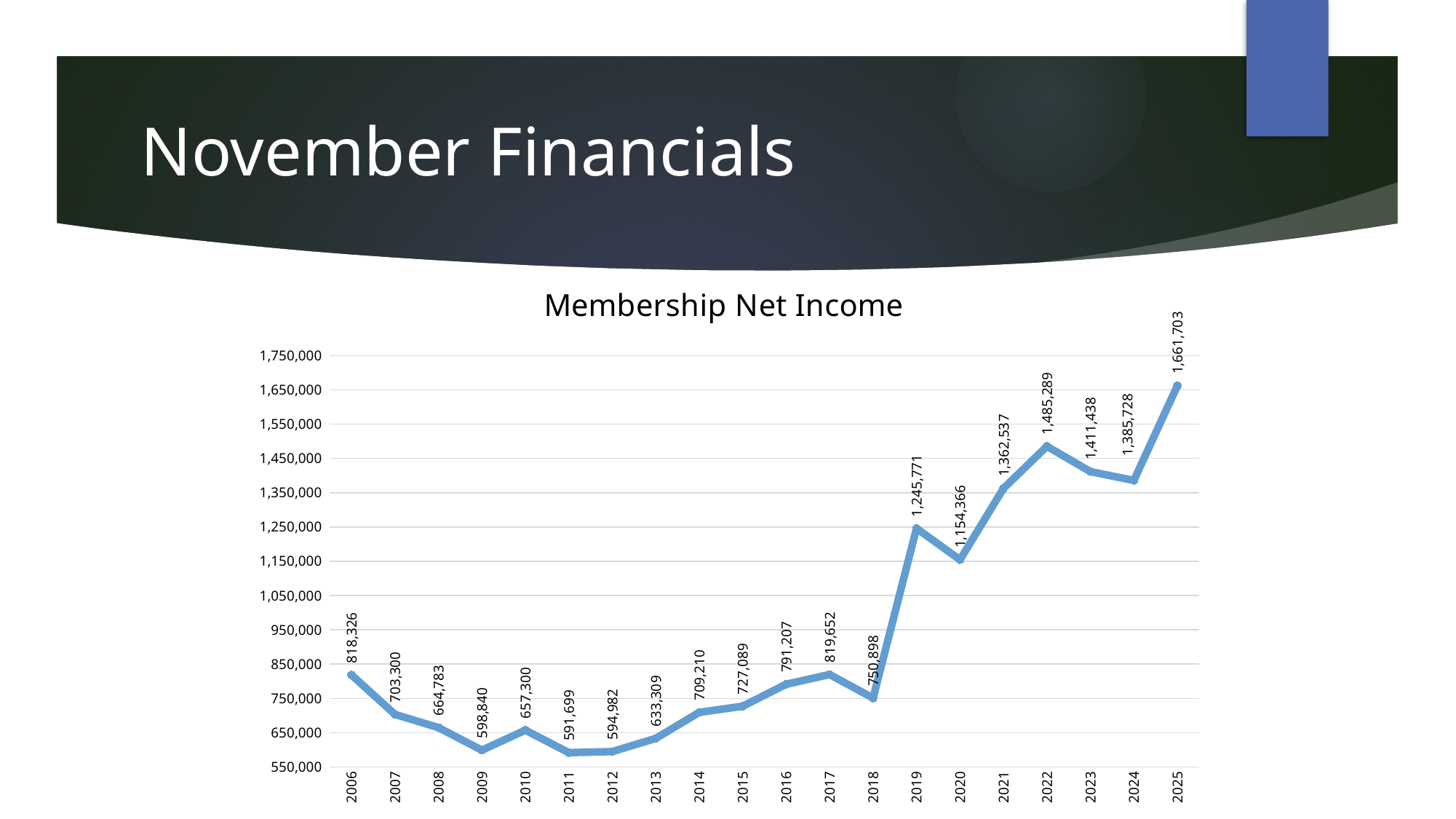
What is the Membership Net Income value for 2019? 1,245,771 What type of chart is shown on the slide? line chart What is the Membership Net Income value for 2006? 818,326 How many years are plotted on the chart? 20 What is the difference between the Membership Net Income in 2019 and in 2018? 494,873 What is the difference between the Membership Net Income in 2025 and in 2024? 275,975 What is the Membership Net Income value for 2022? 1,485,289 What is the title of the chart? Membership Net Income Which year has the highest Membership Net Income? 2025 Does the Membership Net Income generally rise or fall from 2018 to 2025? rise Which year has a higher Membership Net Income, 2020 or 2021? 2021 Which year has the lowest Membership Net Income? 2011